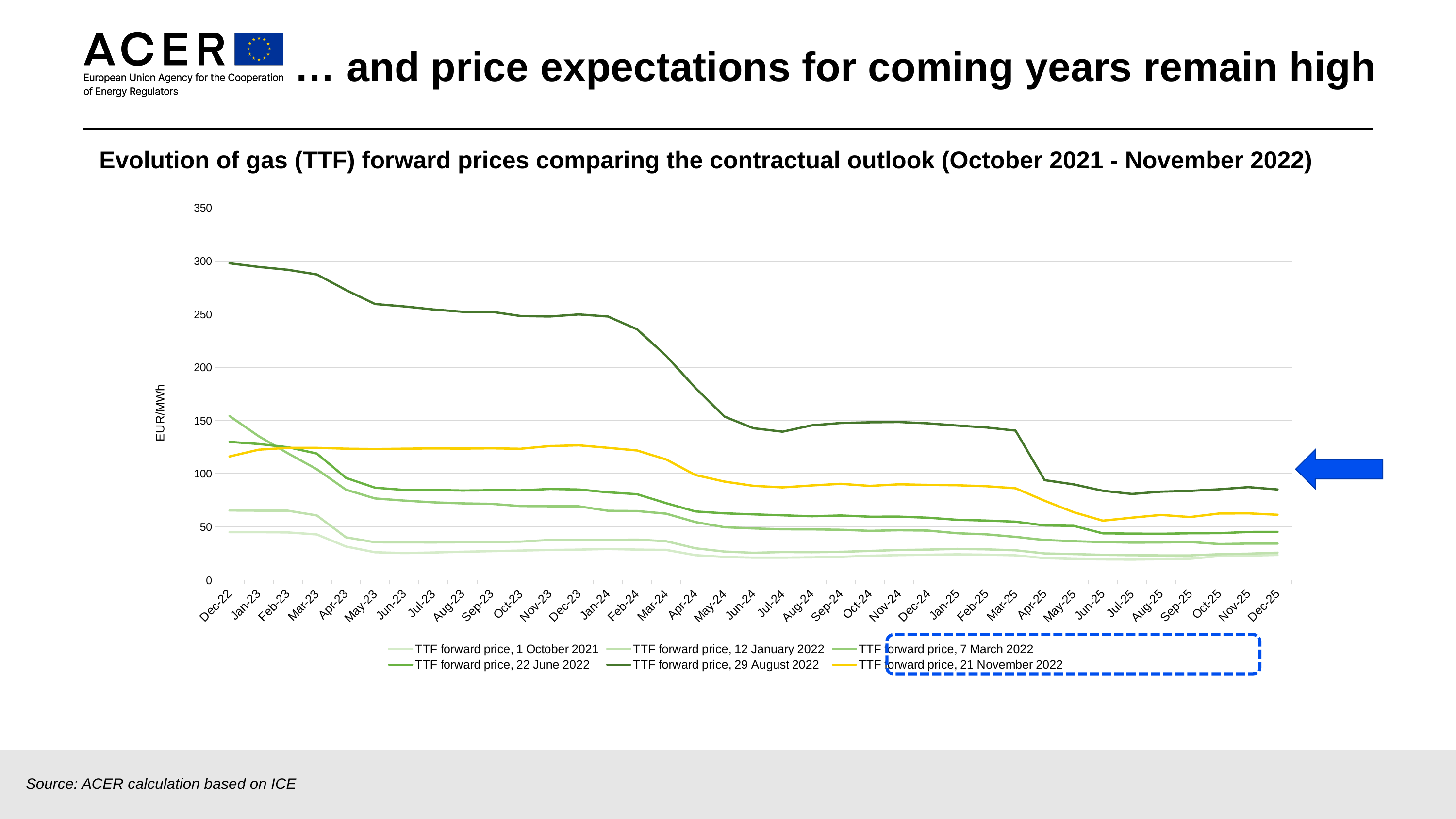
Is the value of the TTF forward price, 29 August 2022 series at Dec-22 greater or less than 250? greater How many series does the legend list? 6 At Dec-25, which is higher: the TTF forward price, 21 November 2022 series or the TTF forward price, 1 October 2021 series? TTF forward price, 21 November 2022 At Dec-22, which is higher: the TTF forward price, 29 August 2022 series or the TTF forward price, 21 November 2022 series? TTF forward price, 29 August 2022 What unit is shown on the y axis of the chart? EUR/MWh Does the TTF forward price, 29 August 2022 series rise or fall from Dec-22 to Dec-25? fall Is the value of the TTF forward price, 21 November 2022 series at Dec-25 greater or less than 100? less How many monthly points are shown along the x axis, from Dec-22 to Dec-25? 37 Is the value of the TTF forward price, 12 January 2022 series at Dec-22 greater or less than 50? greater Which series has the highest value at Dec-22? TTF forward price, 29 August 2022 Which series has the lowest value at Dec-22? TTF forward price, 1 October 2021 What kind of chart is shown on the slide? line chart